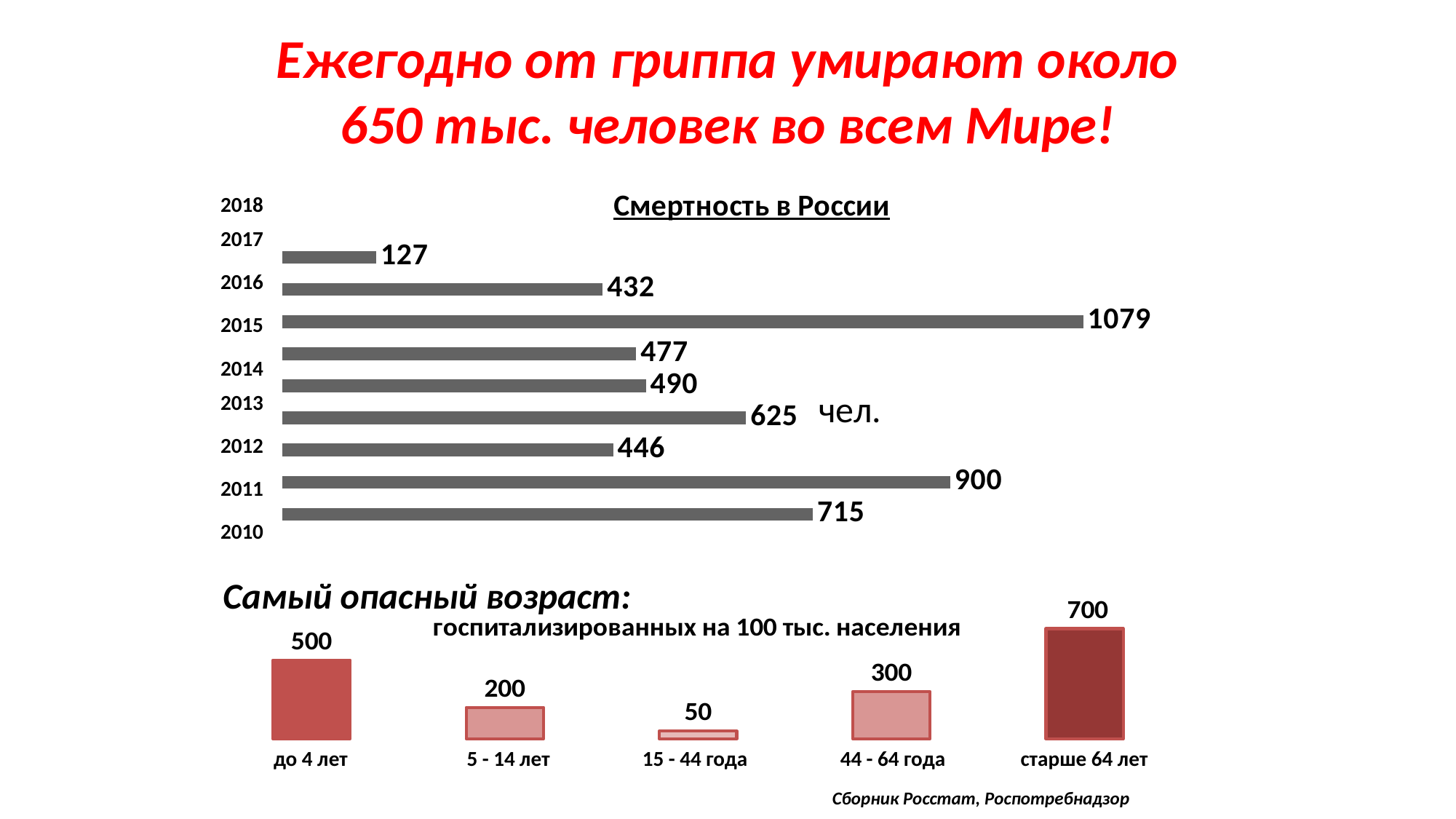
In the 'Смертность в России' chart, what is the difference between the largest bar value (1079) and the smallest bar value (127)? 952 In the bottom chart of hospitalisations per 100 thousand population, what is the value for 'старше 64 лет'? 700 In the bottom chart of hospitalisations per 100 thousand population, what is the value for '15 - 44 года'? 50 In the bottom chart of hospitalisations per 100 thousand population, which age group has the lowest value? 15 - 44 года In the bottom chart of hospitalisations per 100 thousand population, which is larger: '5 - 14 лет' or '44 - 64 года'? 44 - 64 года In the bottom chart of hospitalisations per 100 thousand population, what is the difference between 'до 4 лет' and '44 - 64 года'? 200 In the 'Смертность в России' chart, what is the largest value labelled on any bar? 1079 How many age groups are shown in the bottom chart of hospitalisations per 100 thousand population? 5 In the bottom chart of hospitalisations per 100 thousand population, which age group has the highest value? старше 64 лет In the 'Смертность в России' chart, what is the smallest value labelled on any bar? 127 What kind of chart is 'Смертность в России'? bar chart How many bars are plotted in the 'Смертность в России' chart? 9